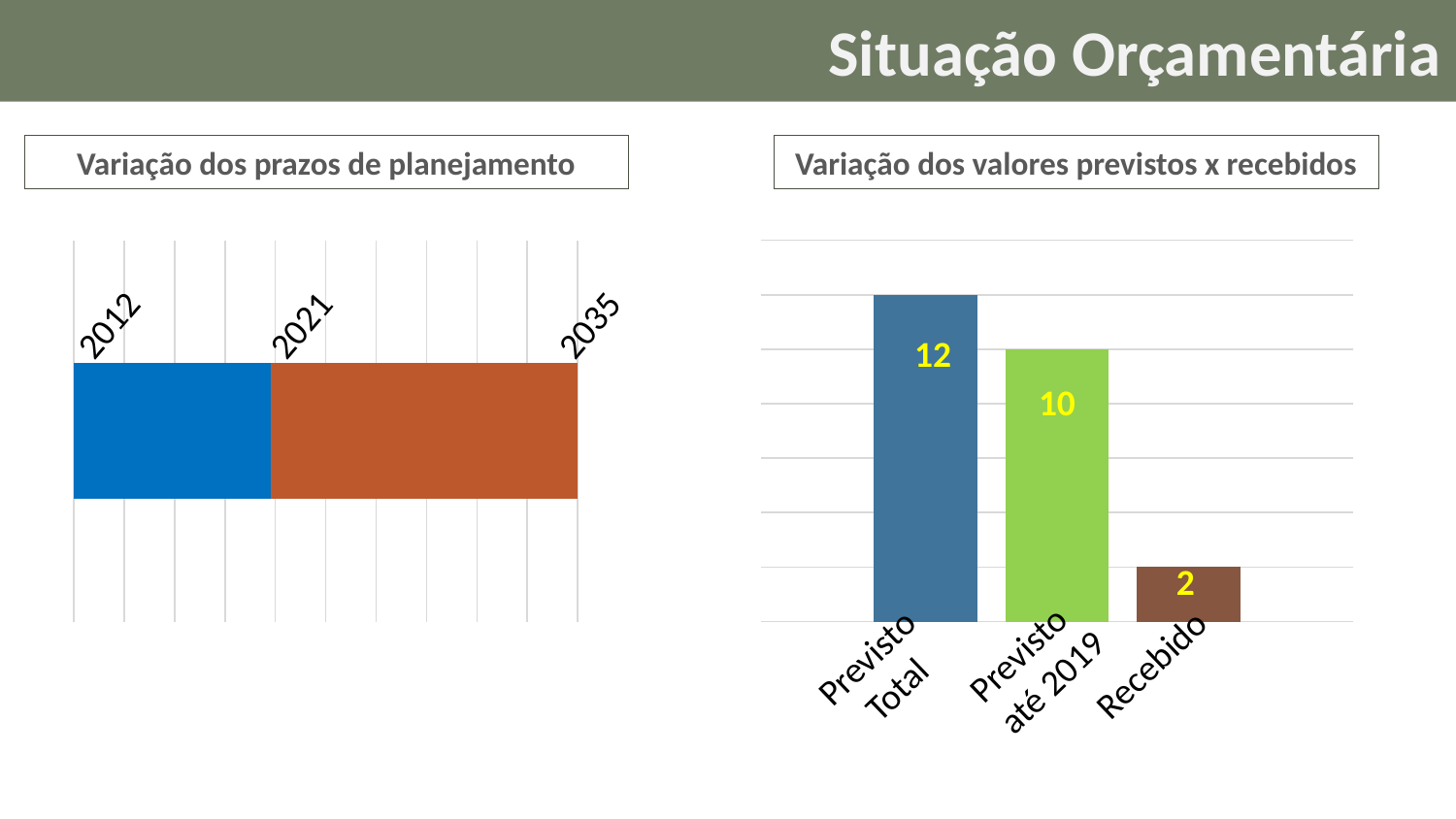
In the chart titled 'Variação dos valores previstos x recebidos', how many categories are plotted? 3 In the chart titled 'Variação dos valores previstos x recebidos', which category has the highest value? Previsto Total What kind of chart is the one titled 'Variação dos valores previstos x recebidos'? Bar chart In the chart titled 'Variação dos valores previstos x recebidos', what is the difference between Previsto até 2019 and Recebido? 8 In the chart titled 'Variação dos valores previstos x recebidos', what is the value for Previsto Total? 12 In the chart titled 'Variação dos valores previstos x recebidos', what is the value for Recebido? 2 In the chart titled 'Variação dos valores previstos x recebidos', do the values rise or fall from left to right? Fall In the chart titled 'Variação dos valores previstos x recebidos', what is the value for Previsto até 2019? 10 In the chart titled 'Variação dos prazos de planejamento', which three year labels are shown along the bar? 2012, 2021, 2035 In the chart titled 'Variação dos valores previstos x recebidos', which category has the lowest value? Recebido In the chart titled 'Variação dos valores previstos x recebidos', which is larger, Previsto até 2019 or Recebido? Previsto até 2019 In the chart titled 'Variação dos valores previstos x recebidos', what is the difference between Previsto Total and Previsto até 2019? 2